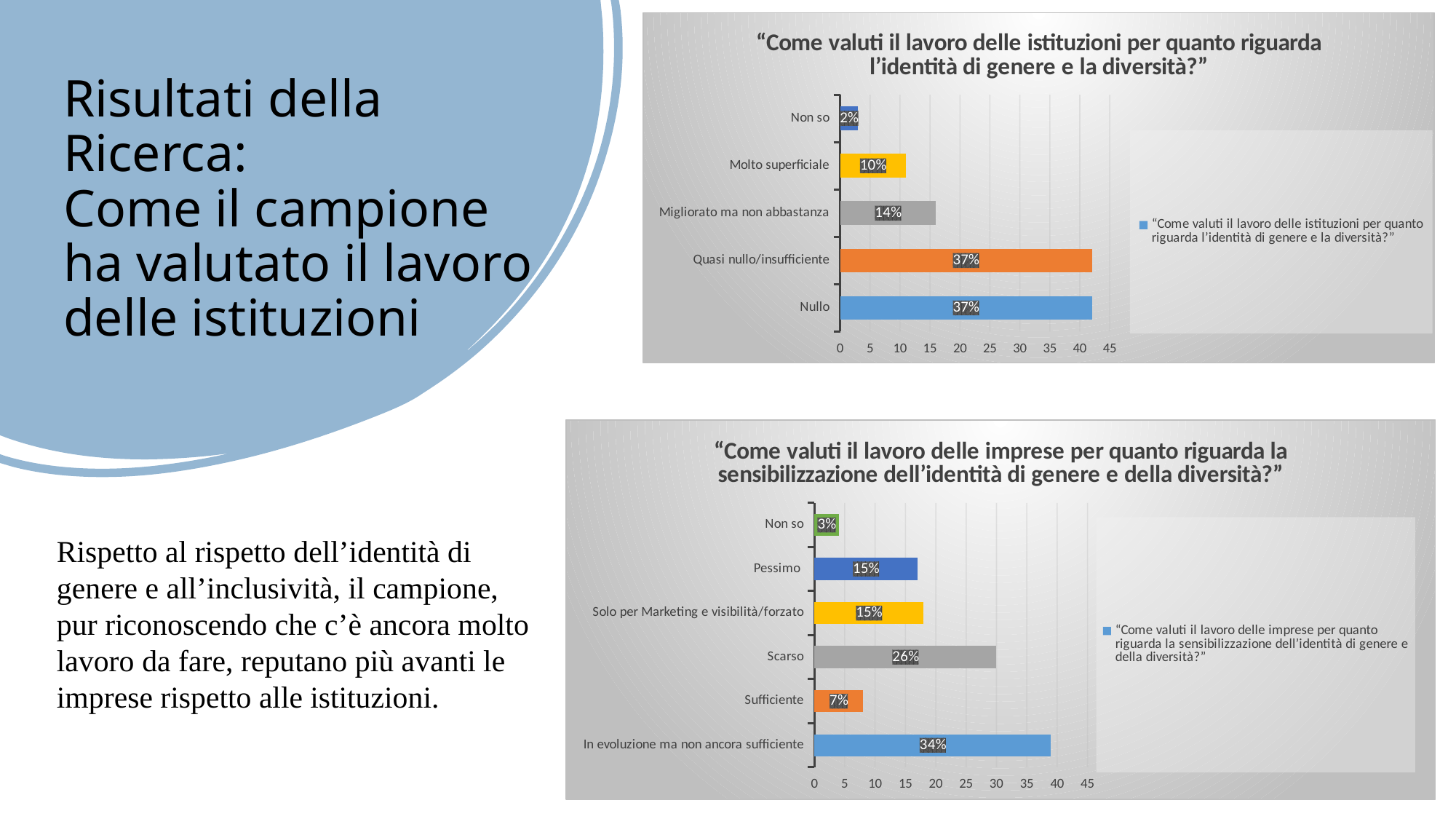
In the top chart about the work of institutions, what percentage is shown for "Migliorato ma non abbastanza"? 14% In the top chart about the work of institutions, what is the difference between "Quasi nullo/insufficiente" and "Molto superficiale"? 27% In the top chart about the work of institutions, what percentage is shown for "Molto superficiale"? 10% In the bottom chart about the work of companies (imprese), how many categories are plotted? 6 In the bottom chart about the work of companies (imprese), which category has the lowest value? Non so In the bottom chart about the work of companies (imprese), which is larger: "Scarso" or "Pessimo"? Scarso In the top chart about the work of institutions, which category has the lowest value? Non so In the top chart about the work of institutions, how many categories are plotted? 5 In the bottom chart about the work of companies (imprese), what percentage is shown for "Sufficiente"? 7% What type of chart is the top chart about the work of institutions? Bar chart In the bottom chart about the work of companies (imprese), which category has the highest value? In evoluzione ma non ancora sufficiente In the bottom chart about the work of companies (imprese), what percentage is shown for "Scarso"? 26%